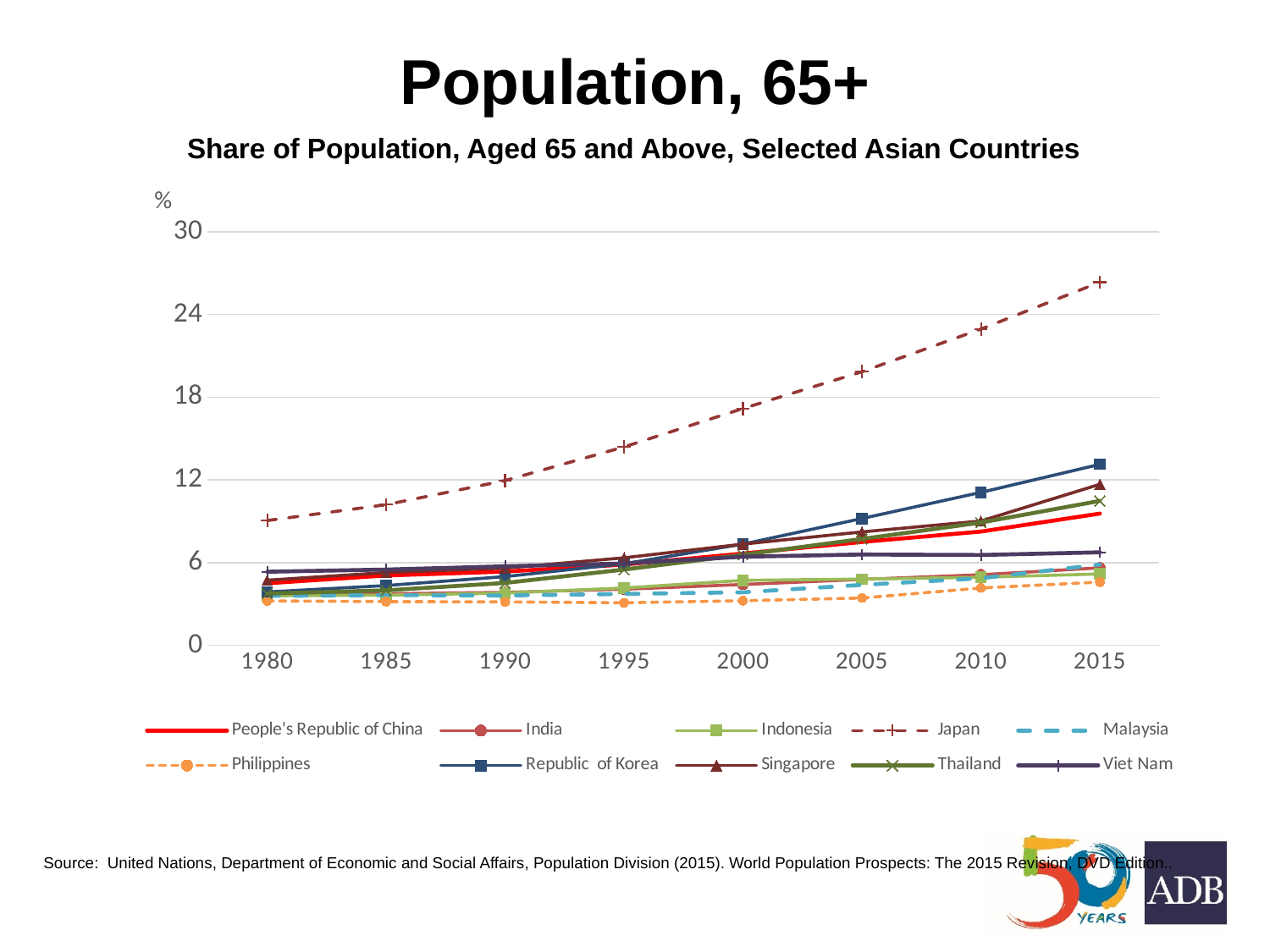
How many years are plotted along the x axis? 8 Is the value for Republic of Korea in 2015 greater or less than 12? greater Is the value for Philippines in 2015 greater or less than 6? less Is the value for Japan in 1980 greater or less than 6? greater What is the subtitle of the chart? Share of Population, Aged 65 and Above, Selected Asian Countries Does the share for Japan rise or fall from 1980 to 2015? rise How many countries does the legend list? 10 Which country has the highest share of population aged 65 and above in 2015? Japan What kind of chart is shown on the slide? line chart Which country has the lowest share of population aged 65 and above in 2015? Philippines In 2015, which is larger: the value for Japan or the value for People's Republic of China? Japan